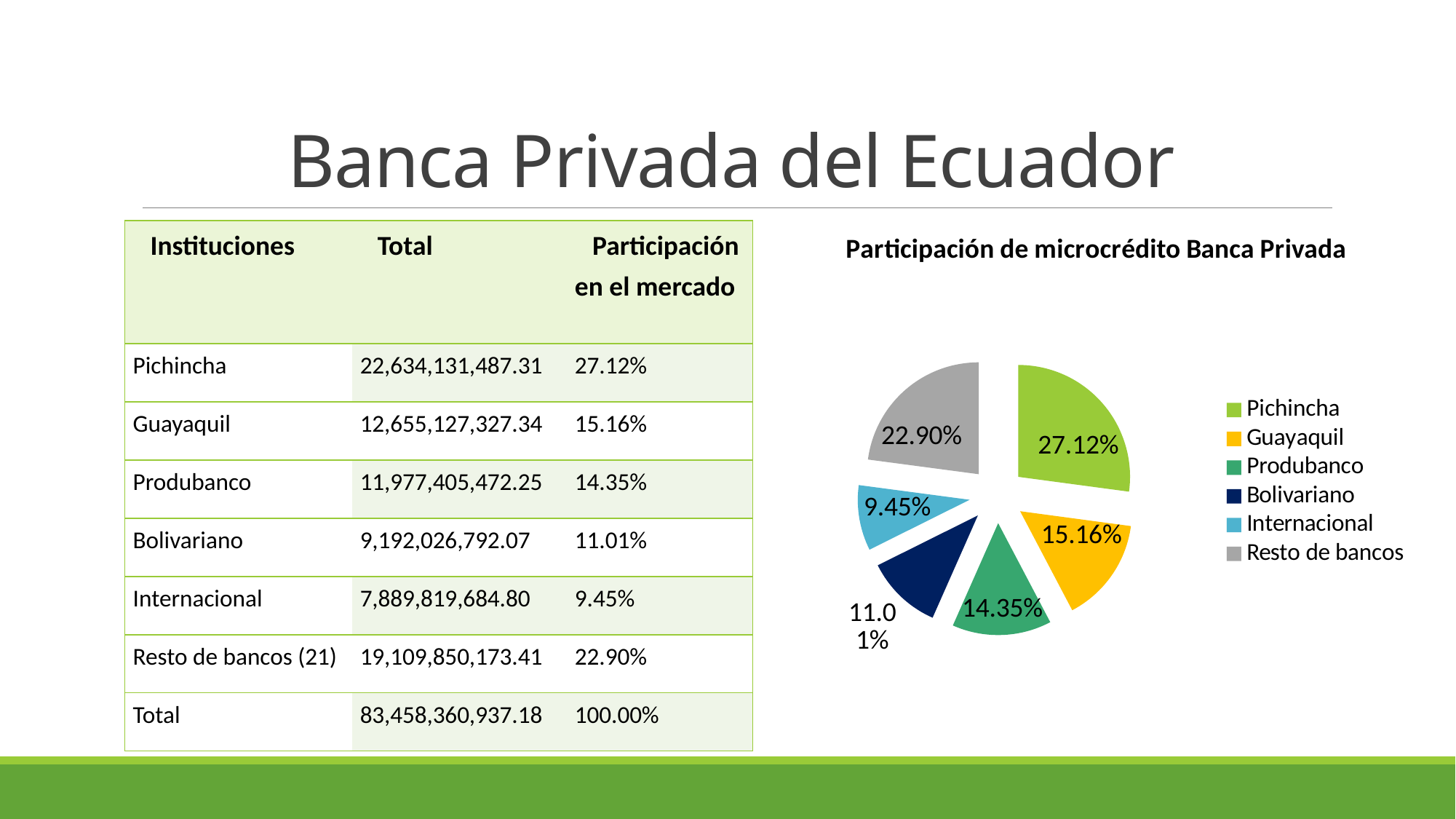
What is the title of the chart? Participación de microcrédito Banca Privada What share of the pie does Resto de bancos have? 22.90% What is the difference between the shares of Pichincha and Guayaquil? 11.96% What share of the pie does Produbanco have? 14.35% How many slices does the pie chart have? 6 What share of the pie does Guayaquil have? 15.16% Which slice of the pie is the smallest? Internacional Which is larger, the share of Resto de bancos or the share of Guayaquil? Resto de bancos What share of the pie does Internacional have? 9.45% Which slice of the pie is the largest? Pichincha What kind of chart is shown on the slide? pie chart What share of the pie does Pichincha have? 27.12%